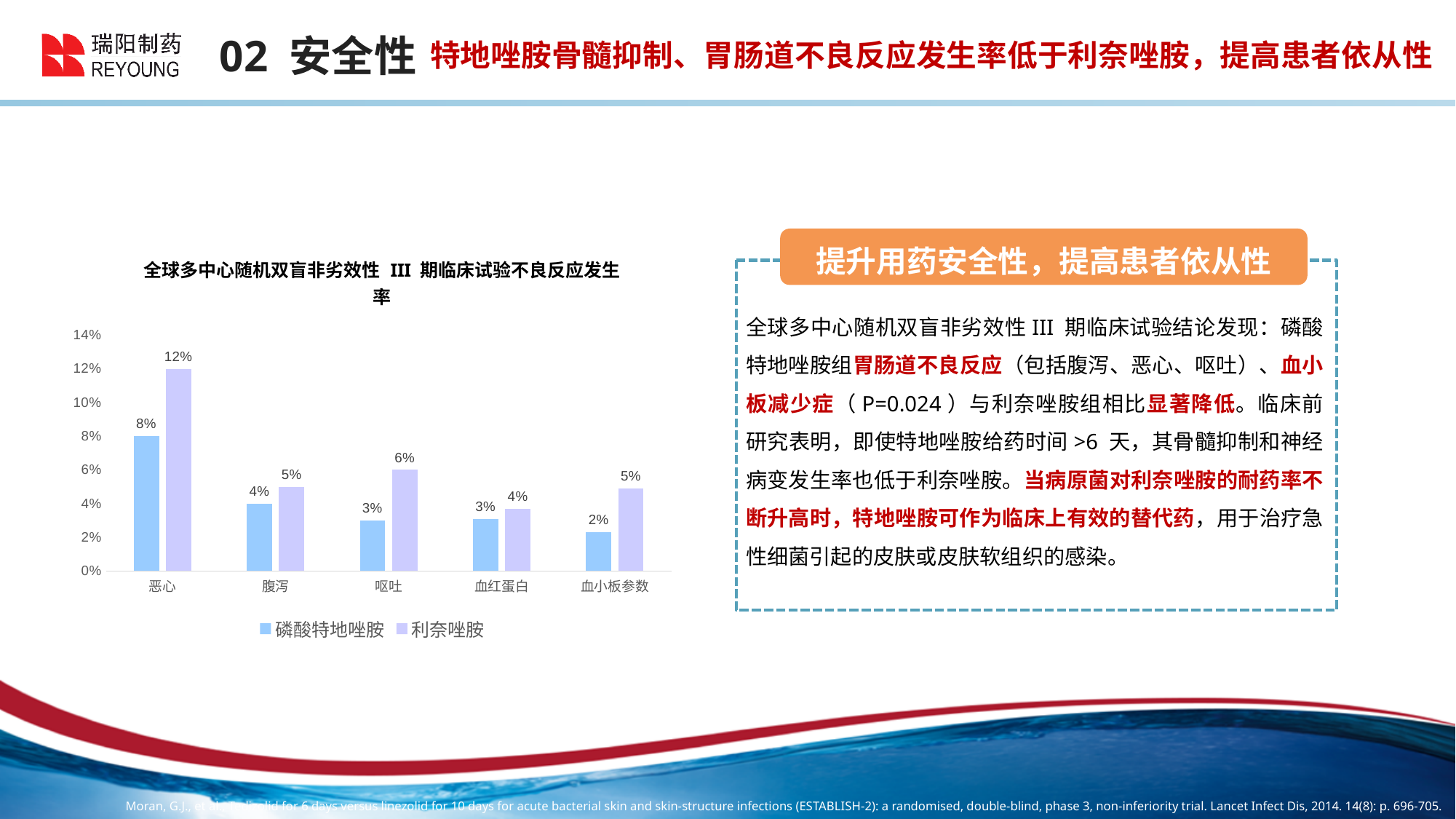
How many categories are shown on the x axis of the chart? 5 What is the difference between the 利奈唑胺 and 磷酸特地唑胺 values in the 恶心 category? 4% What is the adverse reaction rate for 利奈唑胺 in the 呕吐 category? 6% What kind of chart is shown on the slide? bar chart Is the value for 利奈唑胺 in the 恶心 category greater or less than 10%? greater What is the title of the chart? 全球多中心随机双盲非劣效性 III 期临床试验不良反应发生率 Which category has the highest value for 利奈唑胺? 恶心 What is the value for 磷酸特地唑胺 in the 血小板参数 category? 2% In the 呕吐 category, which series has the larger value, 磷酸特地唑胺 or 利奈唑胺? 利奈唑胺 How many series does the chart legend list? 2 Which category has the lowest value for 磷酸特地唑胺? 血小板参数 What is the adverse reaction rate for 磷酸特地唑胺 in the 恶心 category? 8%